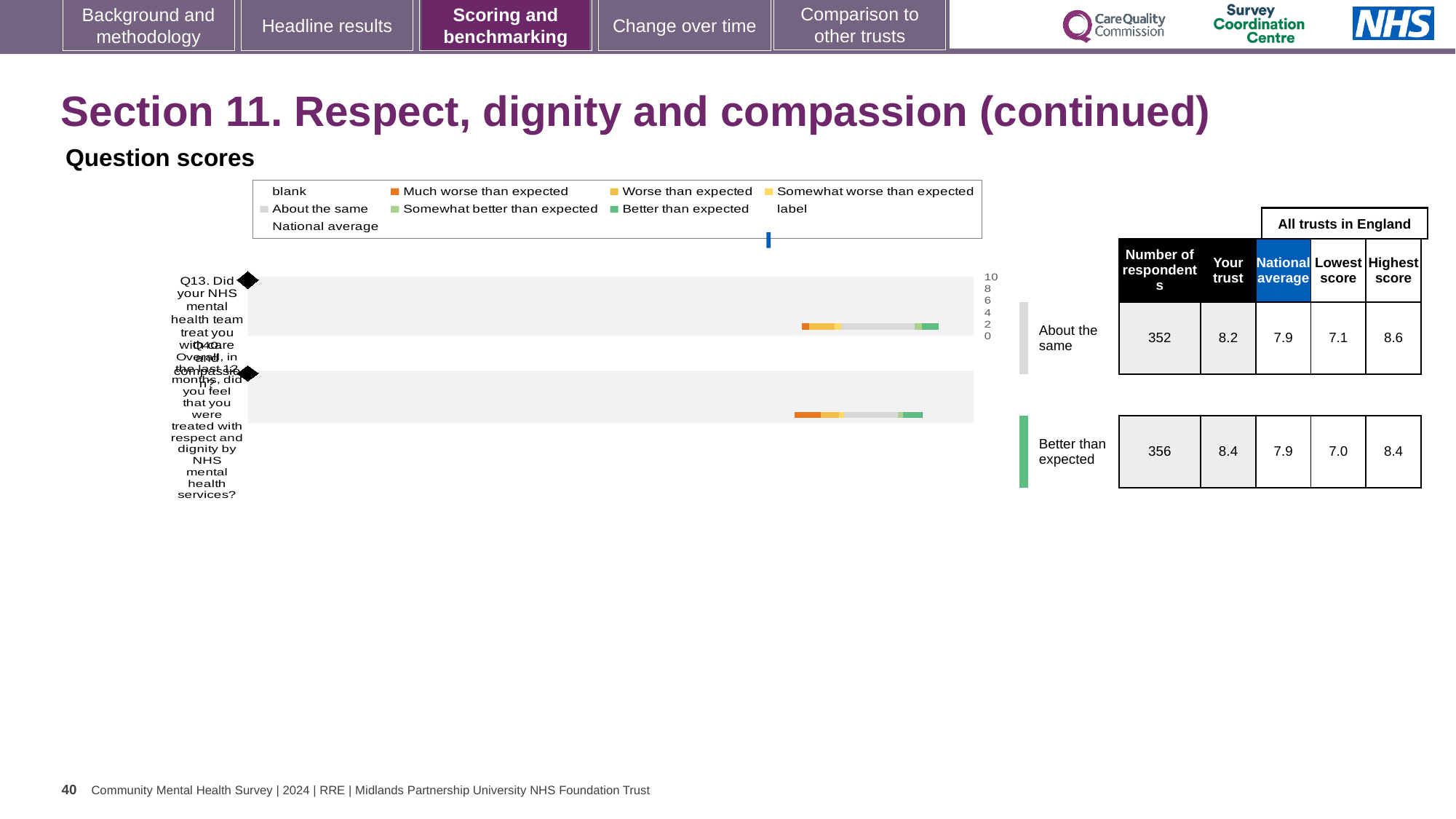
What is the highest score among all trusts in England for Q13? 8.6 What benchmark category is shown for Q13? About the same What kind of chart is shown on the slide? bar chart Which question has the higher 'Your trust' score, Q13 or Q14? Q14 What is the national average score for Q13? 7.9 What benchmark category is shown for Q14? Better than expected What is the 'Your trust' score for Q13 (treated with care and compassion)? 8.2 What is the difference between the trust's score and the national average for Q14? 0.5 How many respondents answered Q14? 356 How many survey questions are plotted in the chart? 2 What is the lowest score among all trusts in England for Q14? 7.0 What is the 'Your trust' score for Q14 (treated with respect and dignity)? 8.4